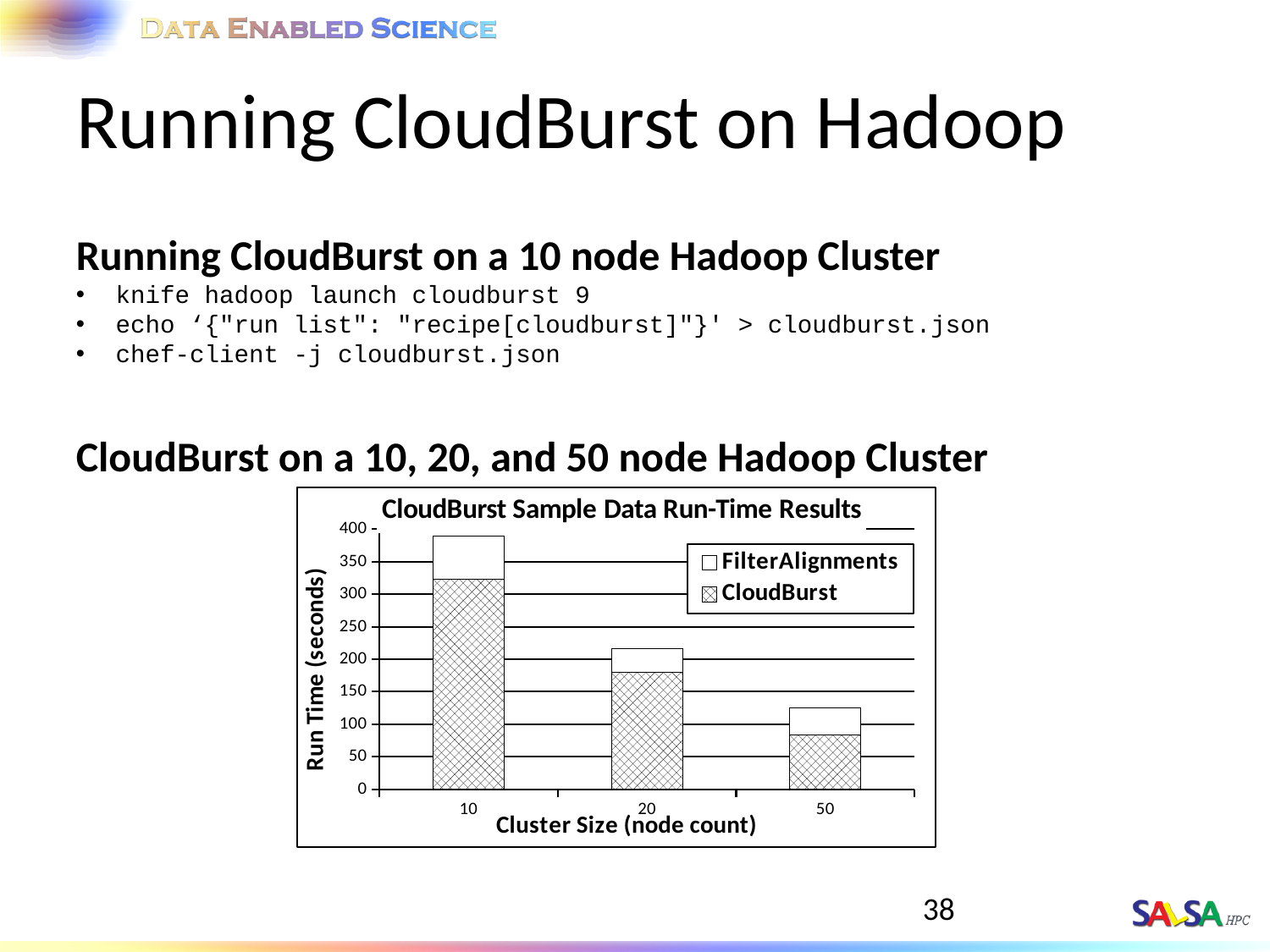
What is the title of the chart? CloudBurst Sample Data Run-Time Results Is the CloudBurst run time for the 20 node cluster greater or less than 150 seconds? greater Is the CloudBurst run time larger for the 20 node cluster or the 50 node cluster? 20 node cluster Which cluster size has the highest total run time? 10 Do the total run times rise or fall as cluster size increases along the x axis? fall Which cluster size has the lowest total run time? 50 Is the CloudBurst run time for the 50 node cluster greater or less than 100 seconds? less Is the CloudBurst run time for the 10 node cluster greater or less than 300 seconds? greater How many cluster sizes are plotted on the x axis? 3 What is the label of the y axis? Run Time (seconds) How many series does the chart legend list? 2 What kind of chart is shown on the slide? bar chart